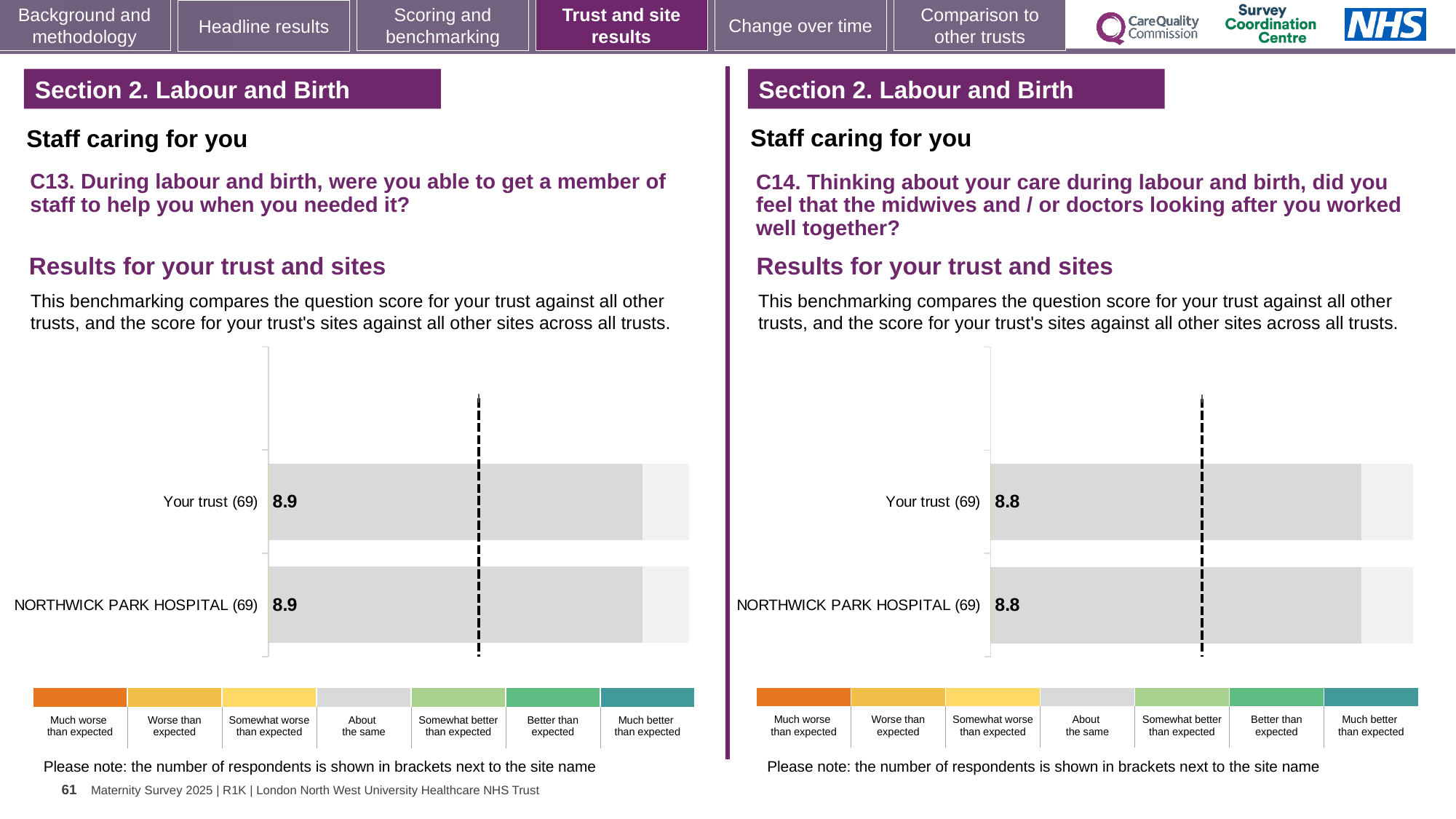
What kind of chart is used on the left (C13)? Bar chart On the right chart (C14), what is the score for Your trust? 8.8 On the right chart (C14), which benchmark category does the grey colour of the bars correspond to in the legend? About the same On the right chart (C14), what is the score for NORTHWICK PARK HOSPITAL? 8.8 On the right chart (C14), what is the difference between the score for Your trust and the score for NORTHWICK PARK HOSPITAL? 0 On the left chart (C13), how many respondents are shown in brackets next to NORTHWICK PARK HOSPITAL? 69 How many bars are plotted on the right chart (C14)? 2 On the left chart (C13), what is the score for NORTHWICK PARK HOSPITAL? 8.9 On the left chart (C13), what is the difference between the score for Your trust and the score for NORTHWICK PARK HOSPITAL? 0 How many categories does the colour legend below the left chart (C13) list? 7 On the left chart (C13), what is the score for Your trust? 8.9 How many bars are plotted on the left chart (C13)? 2